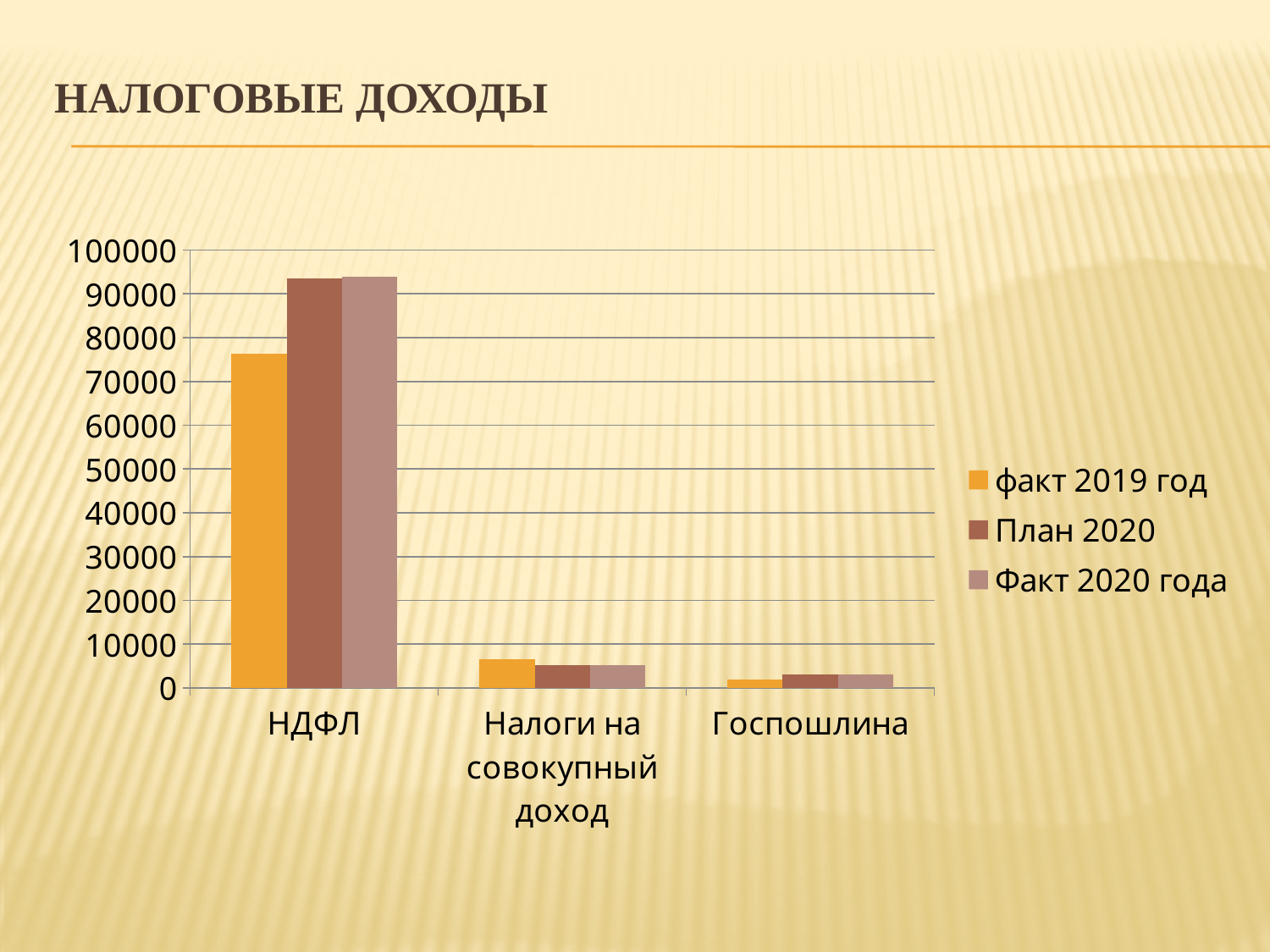
Is the value for факт 2019 год for Налоги на совокупный доход greater or less than 10000? less How many series does the chart legend list? 3 Is the value for факт 2019 год for НДФЛ greater or less than 70000? greater Which category has the lowest values in the chart? Госпошлина Is the value for План 2020 for НДФЛ greater or less than 90000? greater Do the values for факт 2019 год rise or fall from left to right along the x axis? fall How many categories are shown on the x axis of the chart? 3 For Налоги на совокупный доход, which is larger: факт 2019 год or Факт 2020 года? факт 2019 год Which category has the highest values in the chart? НДФЛ What is the title of the slide containing the chart? НАЛОГОВЫЕ ДОХОДЫ What kind of chart is shown on the slide? bar chart For НДФЛ, which is larger: факт 2019 год or План 2020? План 2020